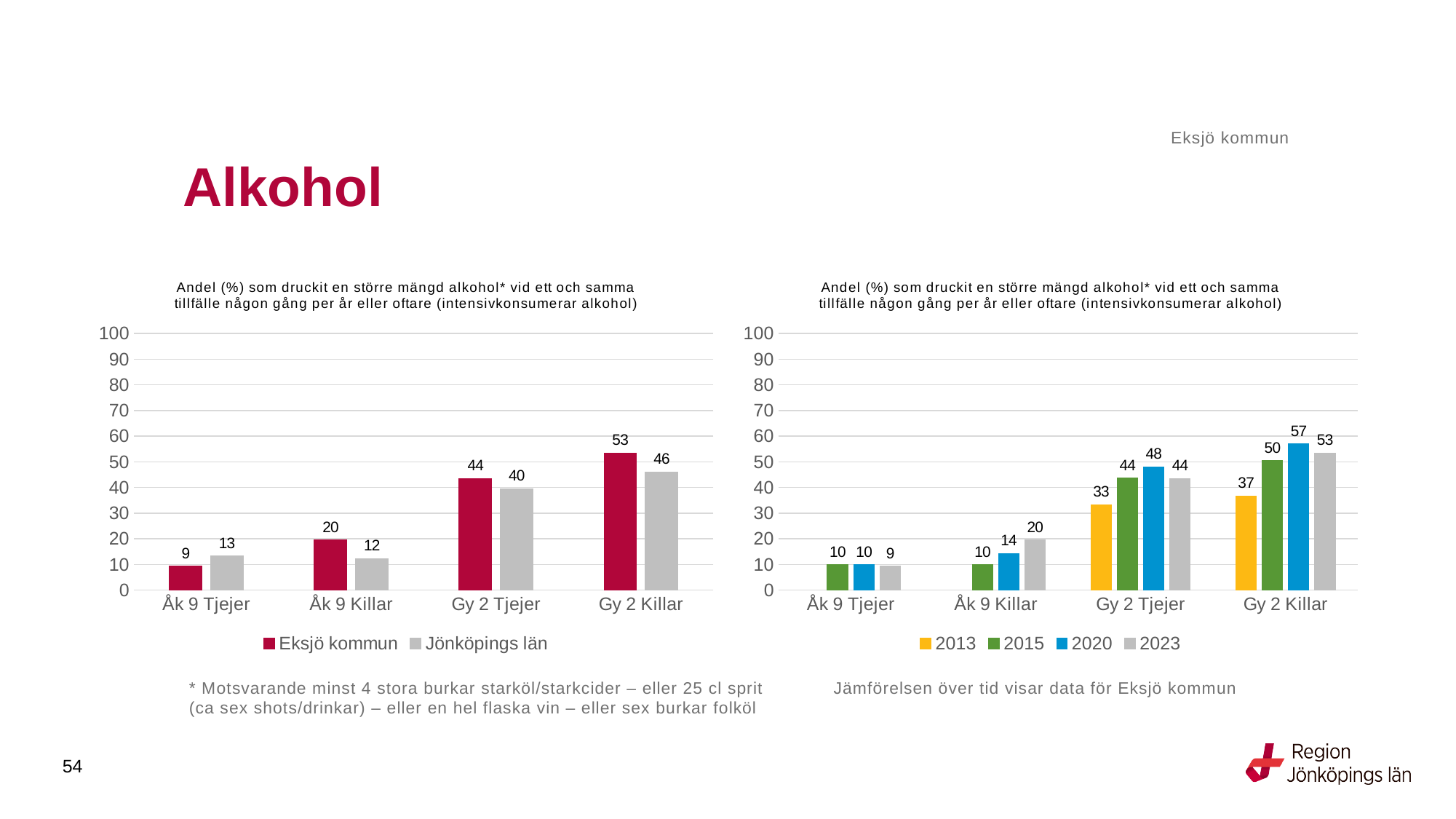
How many series does the legend of the right chart list? 4 In the right chart, what is the difference between the 2023 and 2015 values for Åk 9 Killar? 10 In the right chart, what is the value for 2020 for Gy 2 Killar? 57 In the left chart, what is the difference between Eksjö kommun and Jönköpings län for Åk 9 Killar? 8 In the right chart, what is the value for 2013 for Gy 2 Tjejer? 33 What kind of chart is the right chart? Bar chart How many series does the legend of the left chart list? 2 In the right chart, which year has the highest value for Gy 2 Killar? 2020 In the left chart, what is the value for Eksjö kommun for Gy 2 Killar? 53 In the left chart, which category has the lowest value for Eksjö kommun? Åk 9 Tjejer In the left chart, which is larger for Åk 9 Tjejer: Eksjö kommun or Jönköpings län? Jönköpings län In the left chart, what is the value for Jönköpings län for Åk 9 Tjejer? 13